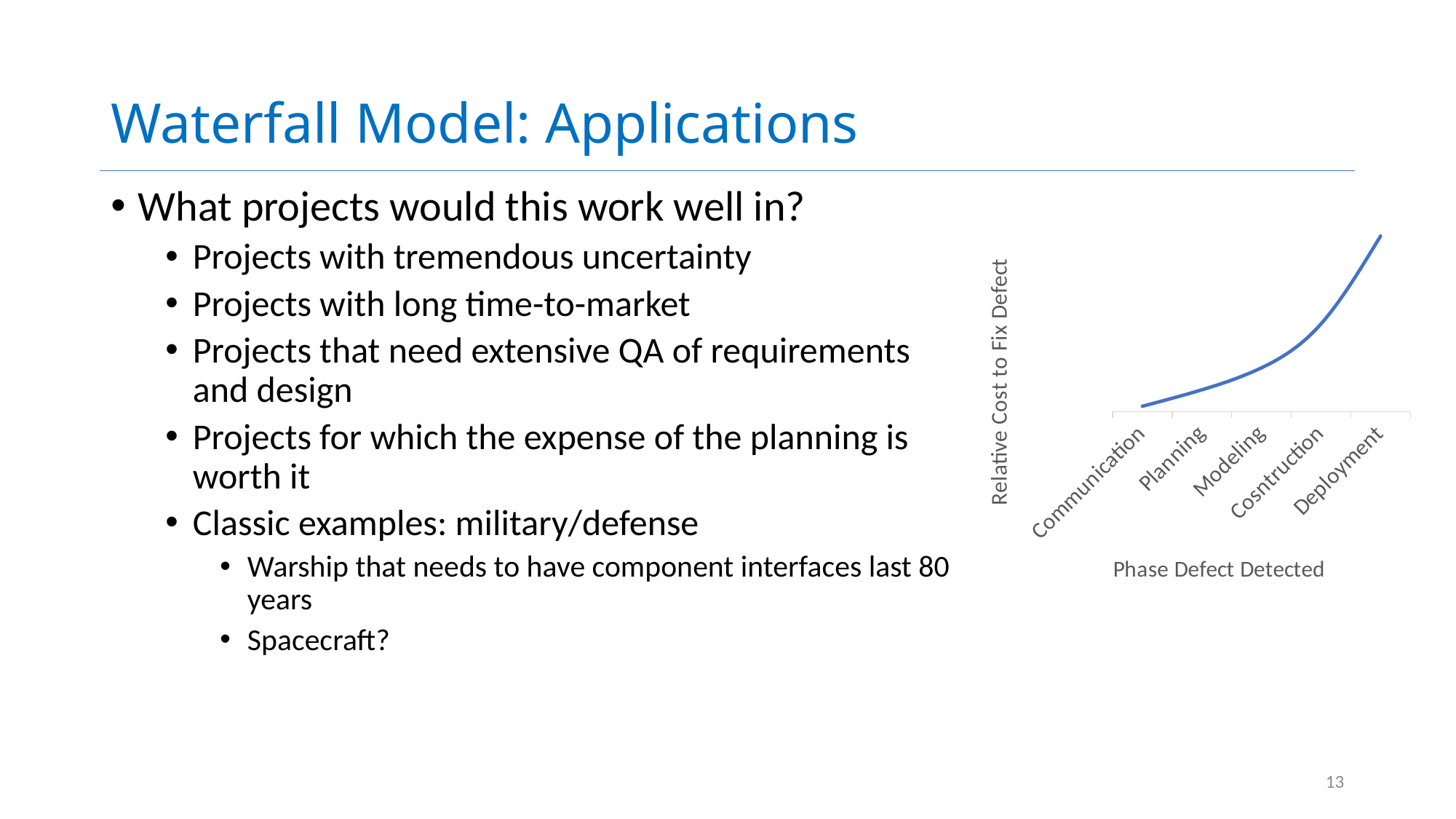
Which phase is the first category on the x axis of the chart? Communication Does the relative cost to fix a defect rise or fall as you move from Communication to Deployment along the x axis? rise Which phase has the highest relative cost to fix a defect? Deployment What kind of chart is shown on the slide? line chart Which phase comes immediately after Modeling on the x axis of the chart? Cosntruction Which phase has the lowest relative cost to fix a defect? Communication What is the title of the chart's horizontal axis? Phase Defect Detected Which phase has a lower relative cost to fix a defect, Modeling or Deployment? Modeling What is the title of the chart's vertical axis? Relative Cost to Fix Defect How many phases are shown along the x axis of the chart? 5 Which phase has a higher relative cost to fix a defect, Planning or Construction? Cosntruction